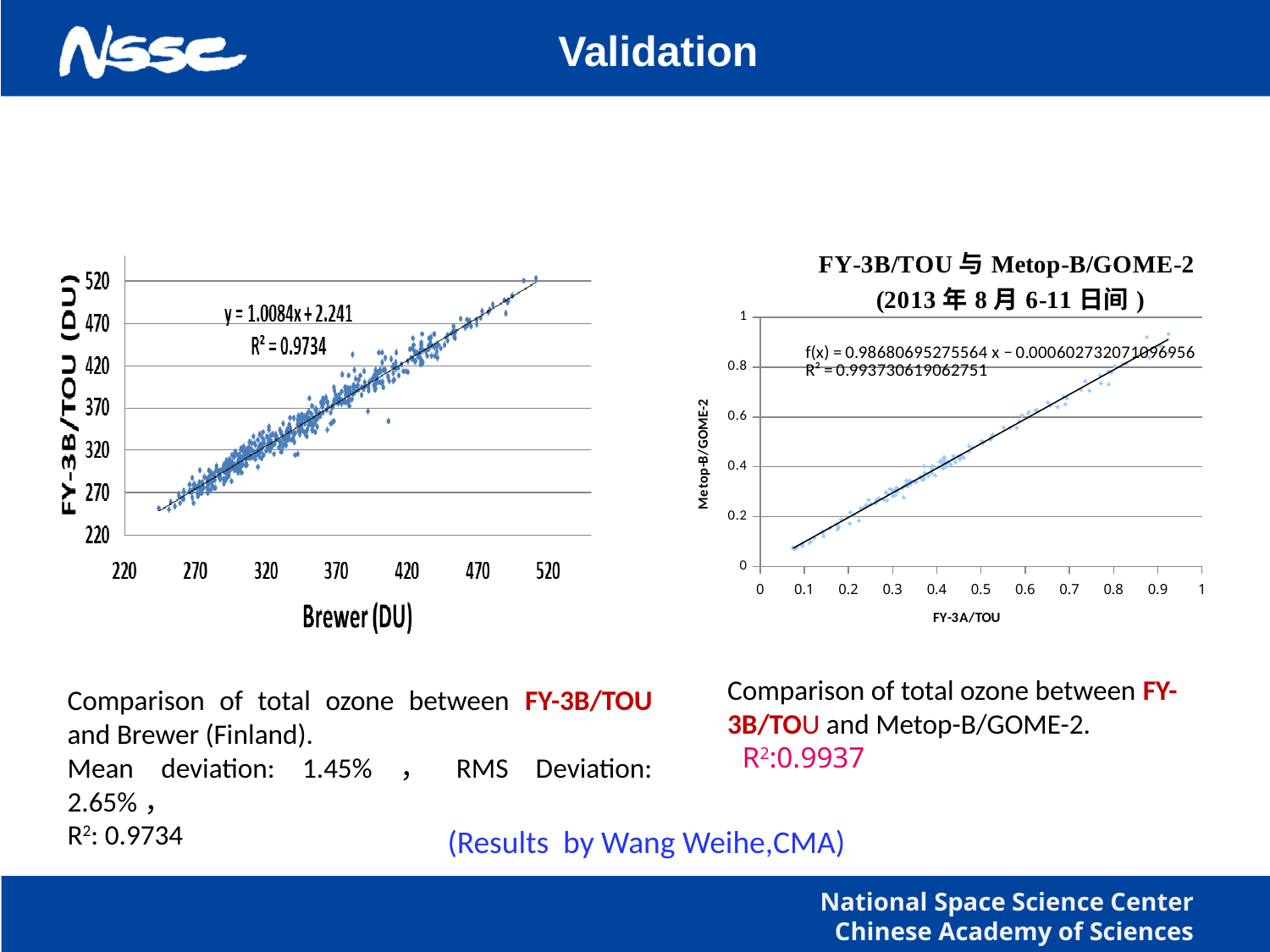
In the left chart, what is the fitted regression equation shown? y = 1.0084x + 2.241 What kind of chart is the left chart comparing FY-3B/TOU and Brewer? Scatter chart What is the y-axis label of the right chart? Metop-B/GOME-2 In the left chart, what is the highest tick value shown on the y axis? 520 In the right chart, do the Metop-B/GOME-2 values rise or fall as the FY-3A/TOU values increase? Rise Which chart has the higher R² value, the left chart (Brewer) or the right chart (Metop-B/GOME-2)? The right chart (Metop-B/GOME-2) In the left chart, what is the R² value printed on the plot? R² = 0.9734 What kind of chart is the right chart titled FY-3B/TOU 与 Metop-B/GOME-2? Scatter chart In the right chart, what is the fitted equation f(x) shown? f(x) = 0.98680695275564 x − 0.000602732071096956 What is the x-axis label of the left chart? Brewer (DU) In the left chart, do the FY-3B/TOU values rise or fall as the Brewer (DU) values increase? Rise In the right chart, what is the R² value printed on the plot? R² = 0.993730619062751